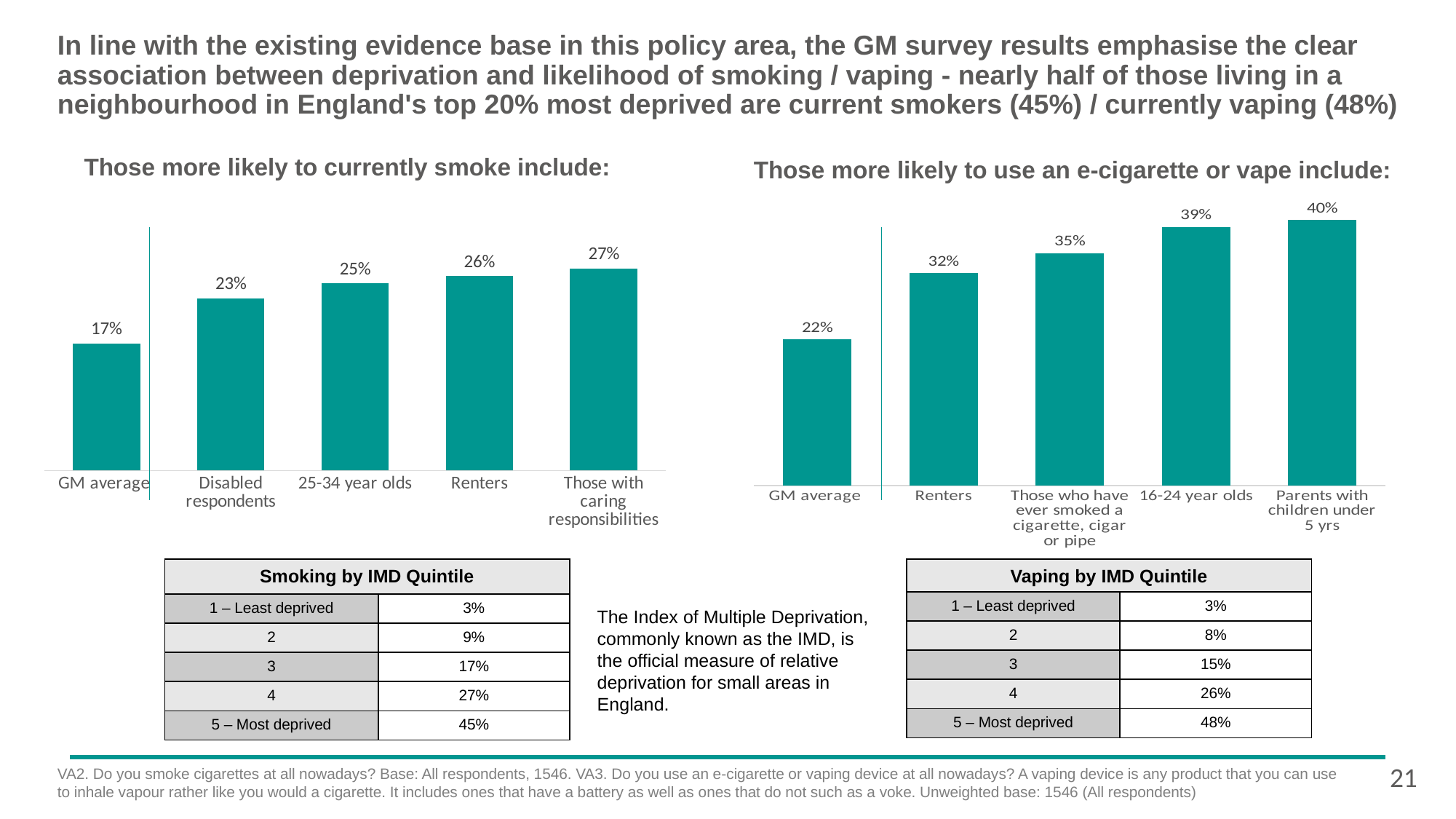
In the chart 'Those more likely to use an e-cigarette or vape include:', what is the value for 16-24 year olds? 39% In the chart 'Those more likely to currently smoke include:', what is the value for Renters? 26% In the chart 'Those more likely to currently smoke include:', which category has the highest value? Those with caring responsibilities In the chart 'Those more likely to use an e-cigarette or vape include:', what is the difference between Parents with children under 5 yrs and GM average? 18% In the chart 'Those more likely to currently smoke include:', what is the difference between Disabled respondents and GM average? 6% In the chart 'Those more likely to currently smoke include:', how many categories are shown? 5 In the chart 'Those more likely to use an e-cigarette or vape include:', which is larger: Renters or 16-24 year olds? 16-24 year olds In the chart 'Those more likely to use an e-cigarette or vape include:', do the values rise or fall from left to right? rise In the chart 'Those more likely to use an e-cigarette or vape include:', what is the value for Those who have ever smoked a cigarette, cigar or pipe? 35% In the chart 'Those more likely to currently smoke include:', what is the value for GM average? 17% In the chart 'Those more likely to use an e-cigarette or vape include:', which category has the lowest value? GM average What type of chart is 'Those more likely to currently smoke include:'? bar chart